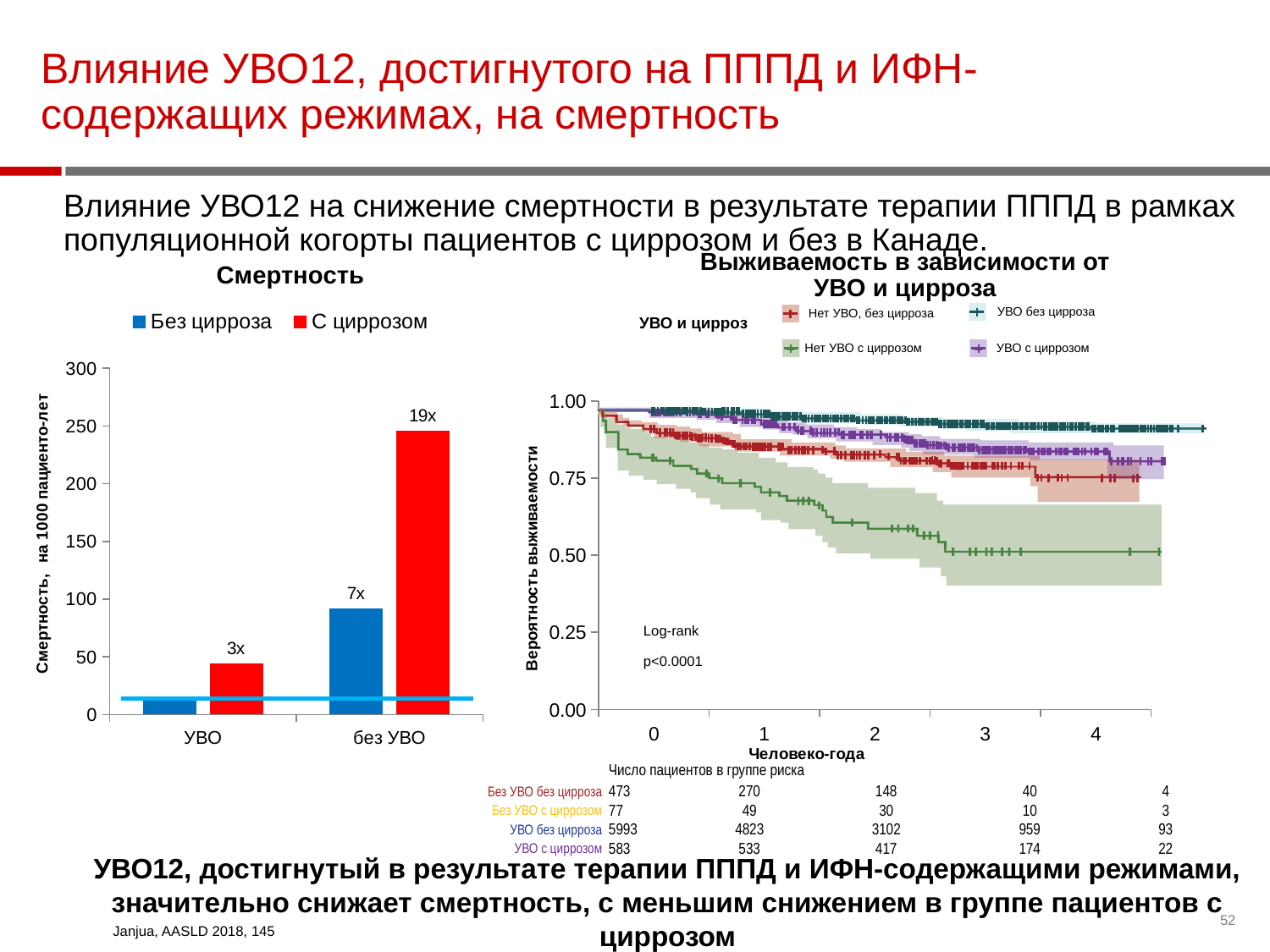
In the left chart "Смертность", how many categories are shown on the x axis? 2 In the left chart "Смертность", which bar is the highest? С циррозом, без УВО In the left chart "Смертность", is the value for "Без цирроза" in the "без УВО" category greater or less than 150? less In the left chart "Смертность", is the value for "С циррозом" in the "УВО" category greater or less than 100? less What kind of chart is the left chart titled "Смертность"? bar chart In the right chart "Выживаемость в зависимости от УВО и цирроза", which group has the lowest survival curve? Нет УВО с циррозом In the right chart "Выживаемость в зависимости от УВО и цирроза", how many series does the legend list? 4 In the left chart "Смертность", how many series does the legend list? 2 In the left chart "Смертность", what label is printed above the tallest bar? 19x In the right chart "Выживаемость в зависимости от УВО и цирроза", what is the number of patients at risk at time 0 for "УВО без цирроза"? 5993 In the left chart "Смертность", is the value for "С циррозом" in the "без УВО" category greater or less than 200? greater In the left chart "Смертность", within the "УВО" category, which series has the larger value: "Без цирроза" or "С циррозом"? С циррозом